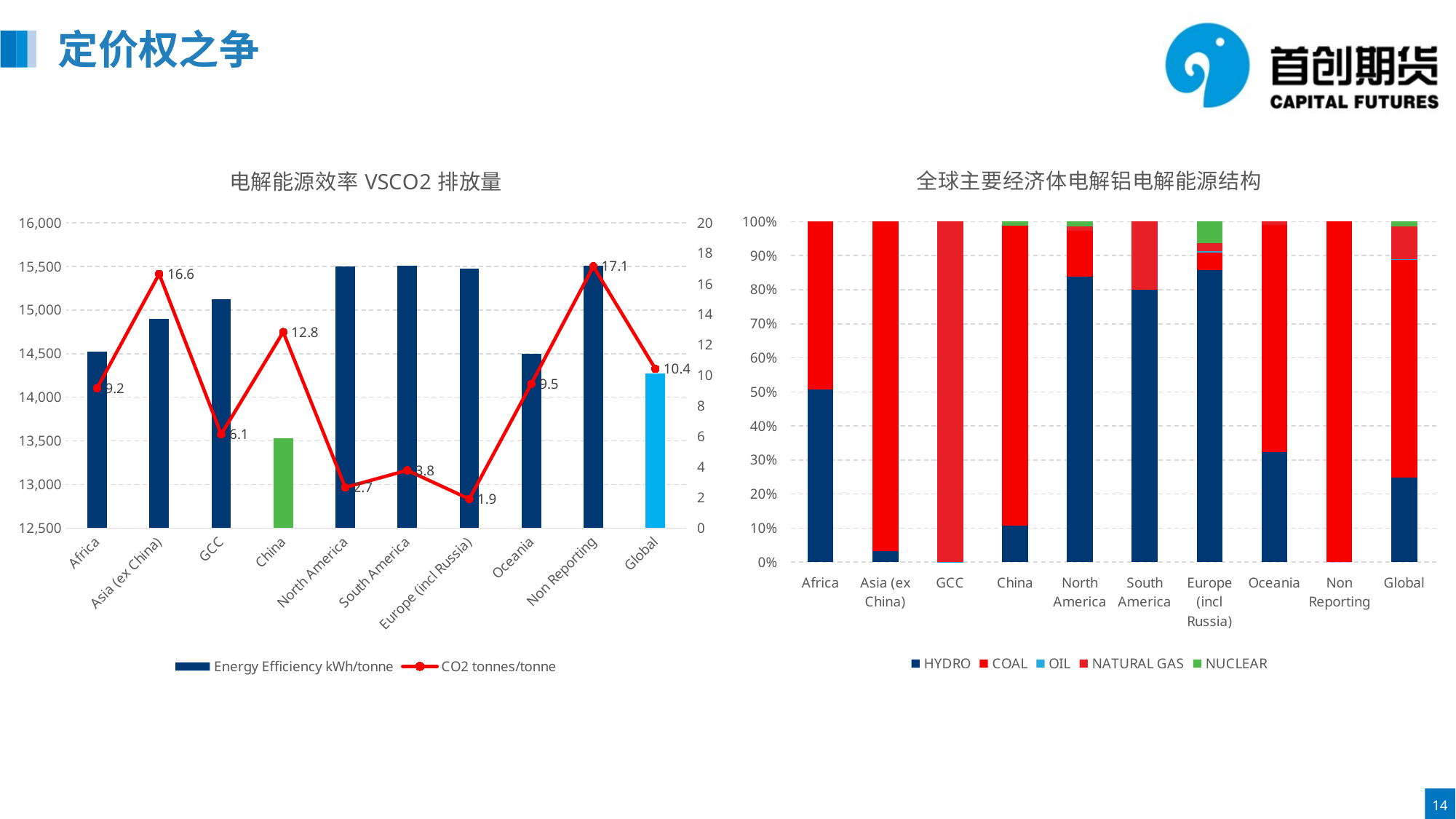
In the left chart (电解能源效率 VSCO2 排放量), which category has the lowest CO2 tonnes/tonne value? Europe (incl Russia) In the right chart (全球主要经济体电解铝电解能源结构), is the HYDRO share for Oceania greater or less than 40%? less What kind of chart is the right chart (全球主要经济体电解铝电解能源结构)? Stacked bar chart In the left chart (电解能源效率 VSCO2 排放量), which category has the highest CO2 tonnes/tonne value? Non Reporting In the left chart (电解能源效率 VSCO2 排放量), what is the CO2 tonnes/tonne value for Global? 10.4 How many series does the legend of the left chart (电解能源效率 VSCO2 排放量) list? 2 In the left chart (电解能源效率 VSCO2 排放量), which has the larger CO2 tonnes/tonne value, China or Oceania? China How many categories are shown on the x axis of the left chart (电解能源效率 VSCO2 排放量)? 10 In the left chart (电解能源效率 VSCO2 排放量), what is the CO2 tonnes/tonne value for Non Reporting? 17.1 In the left chart (电解能源效率 VSCO2 排放量), is the Energy Efficiency kWh/tonne value for Africa greater or less than 14,000? greater How many series does the legend of the right chart (全球主要经济体电解铝电解能源结构) list? 5 In the left chart (电解能源效率 VSCO2 排放量), what is the difference between the CO2 tonnes/tonne values for Asia (ex China) and GCC? 10.5